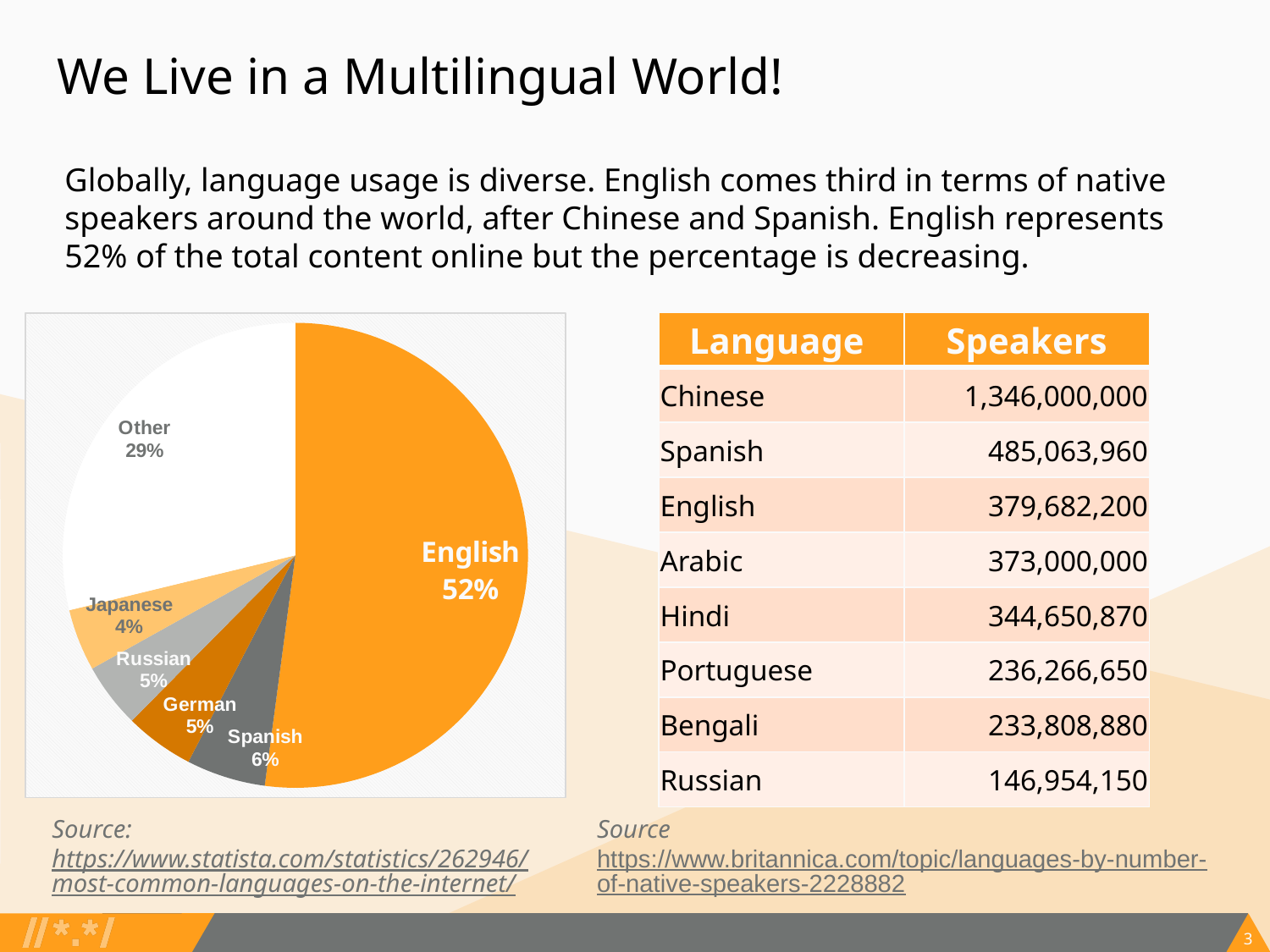
In the pie chart, what share does Japanese have? 4% Which slice of the pie chart is the smallest? Japanese In the pie chart, what share does English have? 52% In the pie chart, which is larger, the Spanish slice or the Japanese slice? Spanish What kind of chart is shown on the left of the slide? Pie chart In the pie chart, what is the difference between the English share and the Other share? 23% In the pie chart, what share does Other have? 29% In the pie chart, what share does German have? 5% How many slices does the pie chart have? 6 Which slice of the pie chart is the largest? English In the pie chart, what is the combined share of Russian and German? 10% In the pie chart, what share does Spanish have? 6%